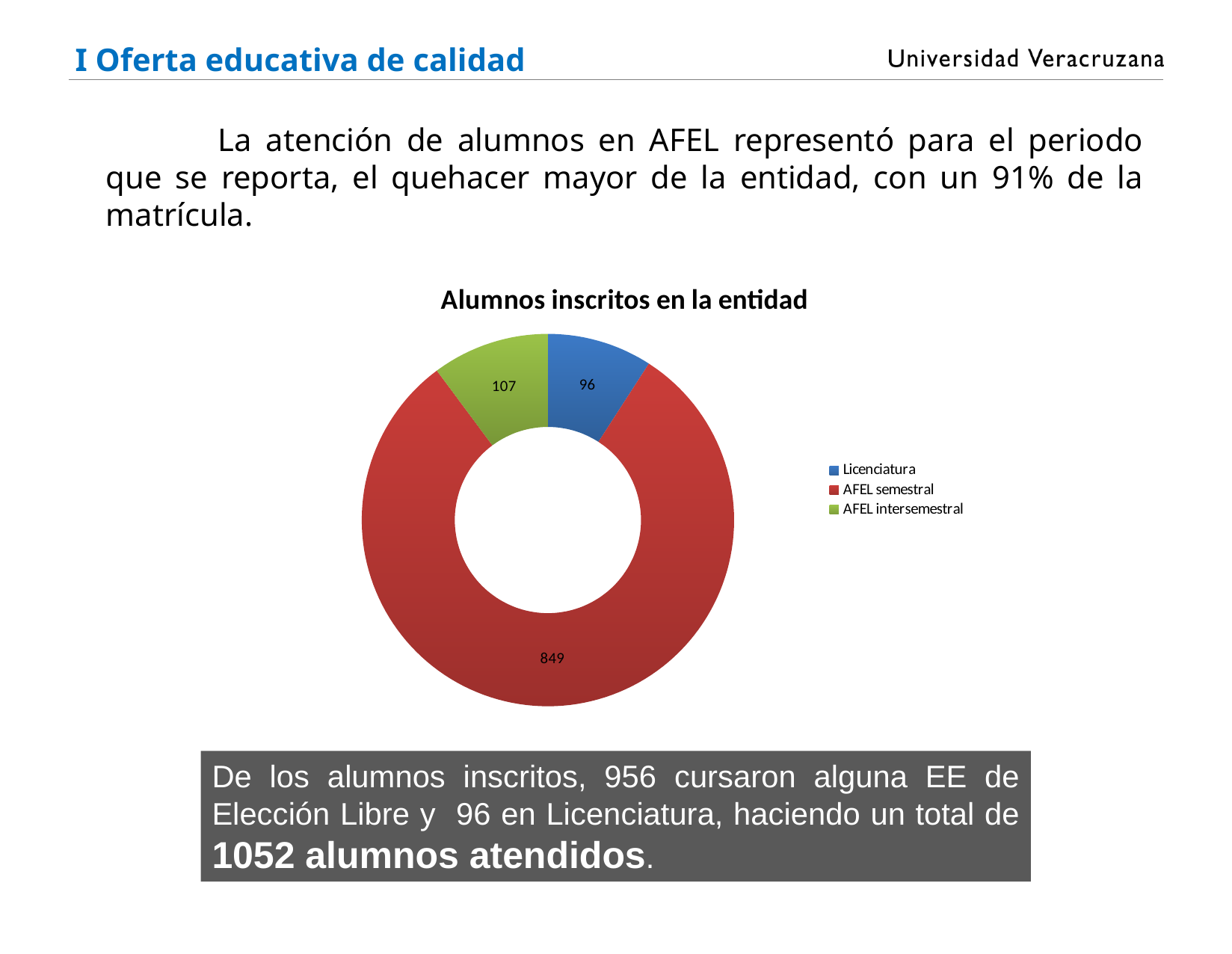
What kind of chart is shown on the slide? doughnut (pie) chart Which is larger, the value for AFEL intersemestral or the value for Licenciatura? AFEL intersemestral What value is shown for AFEL intersemestral in the chart? 107 What value is shown for Licenciatura in the chart? 96 How many categories does the chart show? 3 What is the difference between the AFEL intersemestral and Licenciatura values? 11 What is the difference between the AFEL semestral and AFEL intersemestral values? 742 Which category has the smallest slice in the chart? Licenciatura Which category has the largest slice in the chart? AFEL semestral What is the total of all three values in the chart? 1052 What is the title of the chart? Alumnos inscritos en la entidad What value is shown for AFEL semestral in the chart? 849